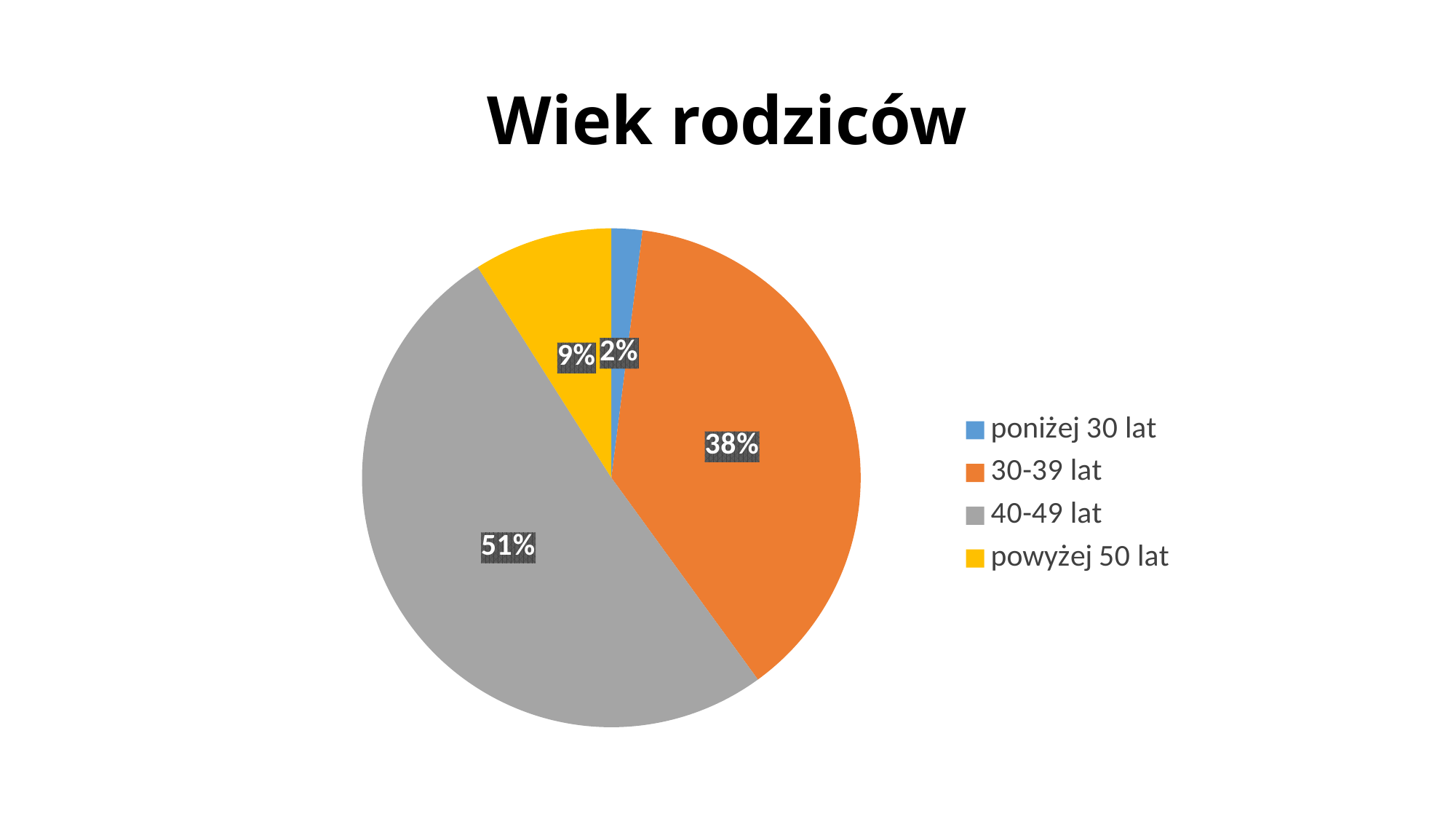
How many slices does the pie chart have? 4 What kind of chart is shown on the slide? Pie chart Which is larger, the share for '30-39 lat' or the share for 'powyżej 50 lat'? 30-39 lat What share of the pie does the '40-49 lat' slice represent? 51% Which age group has the largest share of the pie? 40-49 lat What is the title of the chart? Wiek rodziców What is the value shown for '30-39 lat'? 38% What is the difference between the shares for 'powyżej 50 lat' and 'poniżej 30 lat'? 7% What is the value shown for 'powyżej 50 lat'? 9% What is the difference between the shares for '40-49 lat' and '30-39 lat'? 13% What is the value shown for 'poniżej 30 lat'? 2% Which age group has the smallest share of the pie? poniżej 30 lat